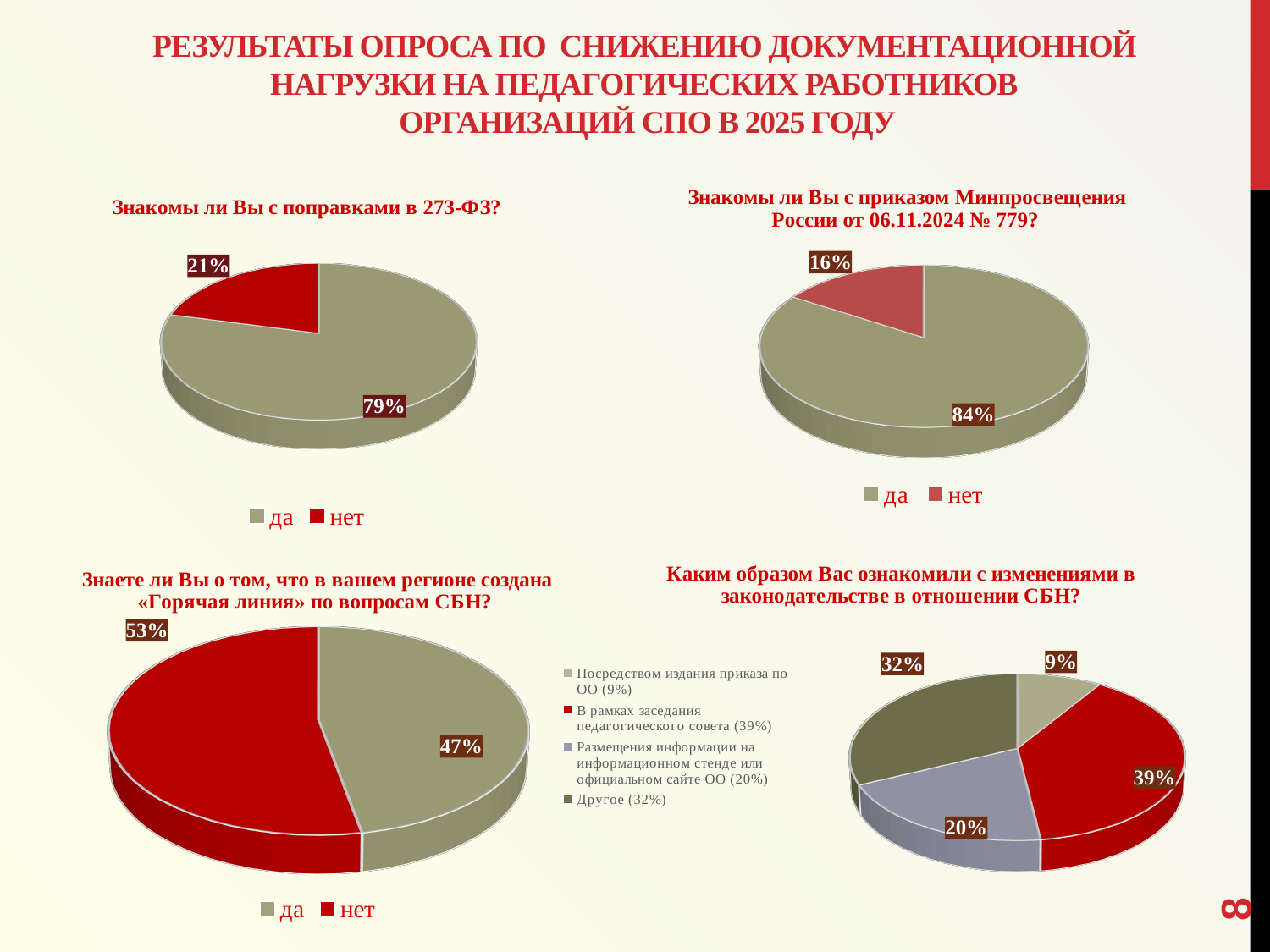
In the chart "Знаете ли Вы о том, что в вашем регионе создана «Горячая линия» по вопросам СБН?", which answer has the larger share, "да" or "нет"? нет In the chart "Каким образом Вас ознакомили с изменениями в законодательстве в отношении СБН?", what share is "Другое"? 32% In the chart "Знакомы ли Вы с поправками в 273-ФЗ?", what share of respondents answered "да"? 79% What type of chart is used for "Знакомы ли Вы с поправками в 273-ФЗ?"? Pie chart How many charts are shown on the slide? 4 In the chart "Знакомы ли Вы с приказом Минпросвещения России от 06.11.2024 № 779?", what share answered "нет"? 16% In the chart "Знакомы ли Вы с приказом Минпросвещения России от 06.11.2024 № 779?", what is the difference between the "да" and "нет" shares? 68% How many categories does the legend of the chart "Каким образом Вас ознакомили с изменениями в законодательстве в отношении СБН?" list? 4 In the chart "Знаете ли Вы о том, что в вашем регионе создана «Горячая линия» по вопросам СБН?", what share answered "да"? 47% In the chart "Каким образом Вас ознакомили с изменениями в законодательстве в отношении СБН?", which category has the smallest share? Посредством издания приказа по ОО In the chart "Знакомы ли Вы с поправками в 273-ФЗ?", what share of respondents answered "нет"? 21% In the chart "Каким образом Вас ознакомили с изменениями в законодательстве в отношении СБН?", which category has the largest share? В рамках заседания педагогического совета